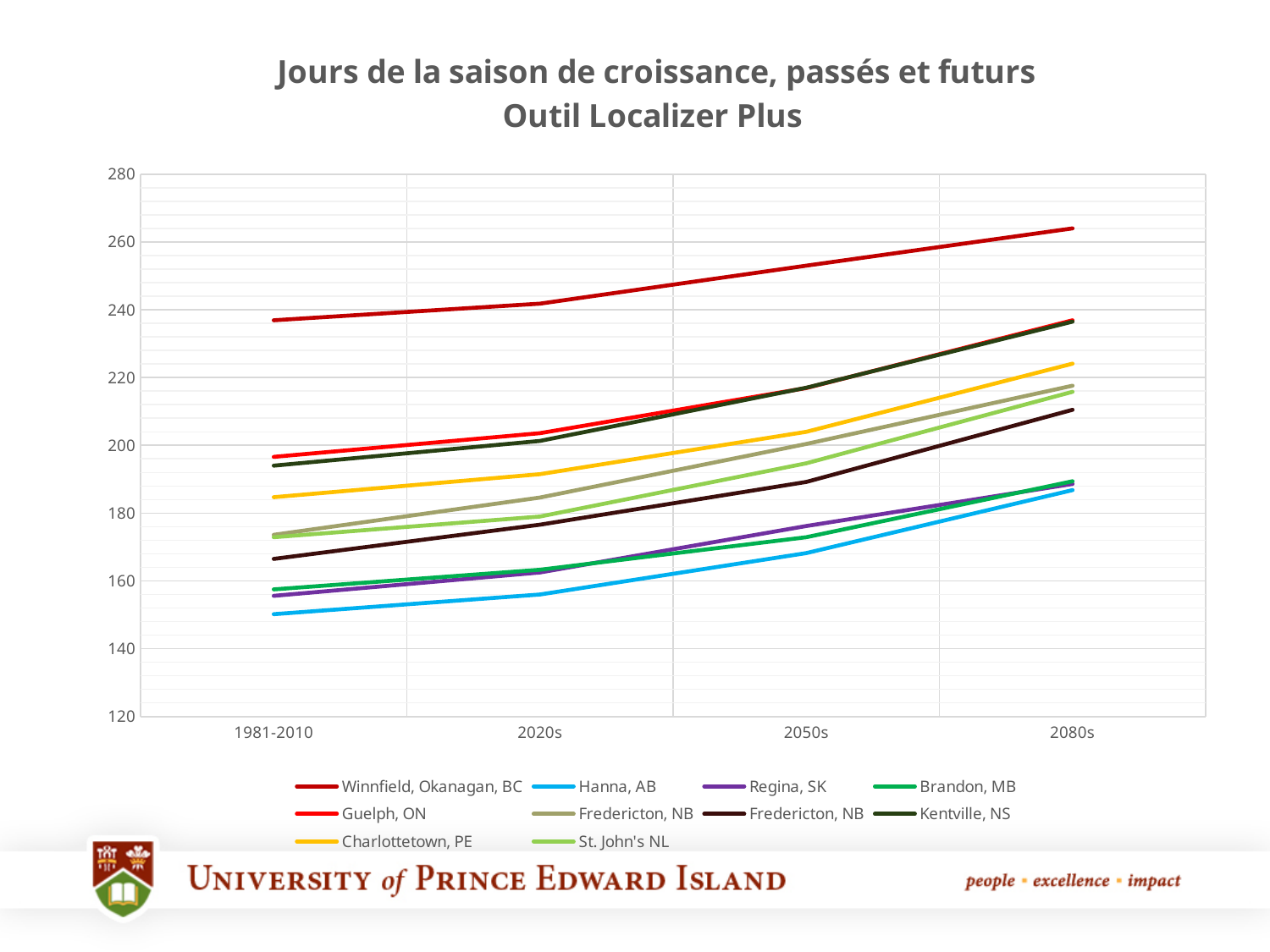
In the 2080s, which is larger: the value for Winnfield, Okanagan, BC or the value for Guelph, ON? Winnfield, Okanagan, BC How many time periods are shown on the x axis? 4 How many series does the legend list? 10 What kind of chart is shown on the slide? line chart Which location has the lowest values across all periods? Hanna, AB Is the value for Winnfield, Okanagan, BC in the 2080s greater or less than 260? greater What is the title of the chart? Jours de la saison de croissance, passés et futurs Outil Localizer Plus Is the value for Charlottetown, PE in the 2080s greater or less than 220? greater Which location has the highest values across all periods? Winnfield, Okanagan, BC Is the value for Guelph, ON in 1981-2010 greater or less than 200? less Do the values for Winnfield, Okanagan, BC rise or fall from 1981-2010 to the 2080s? rise